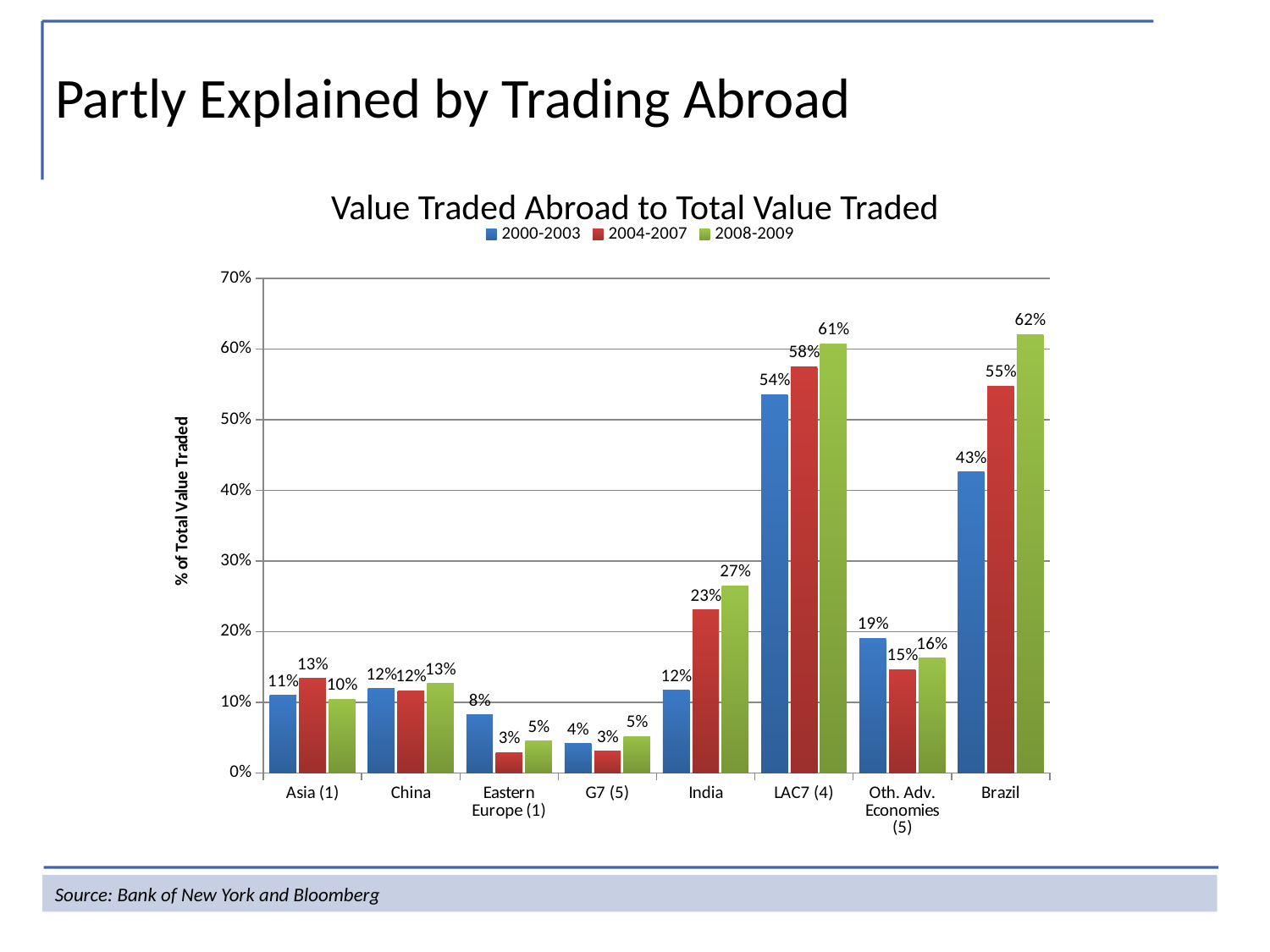
Is the 2004-2007 value for LAC7 (4) greater or less than 50%? greater What is the difference between the 2008-2009 and 2000-2003 values for Brazil? 19% What is the title of the chart? Value Traded Abroad to Total Value Traded How many categories are shown on the x axis? 8 Which category has the highest value in the 2000-2003 series? LAC7 (4) What kind of chart is shown on the slide? Bar chart Which is larger for India: the 2000-2003 value or the 2008-2009 value? 2008-2009 What is the value for India in the 2004-2007 series? 23% How many series does the legend list? 3 What is the value for Oth. Adv. Economies (5) in the 2000-2003 series? 19% What is the value for Brazil in the 2008-2009 series? 62%